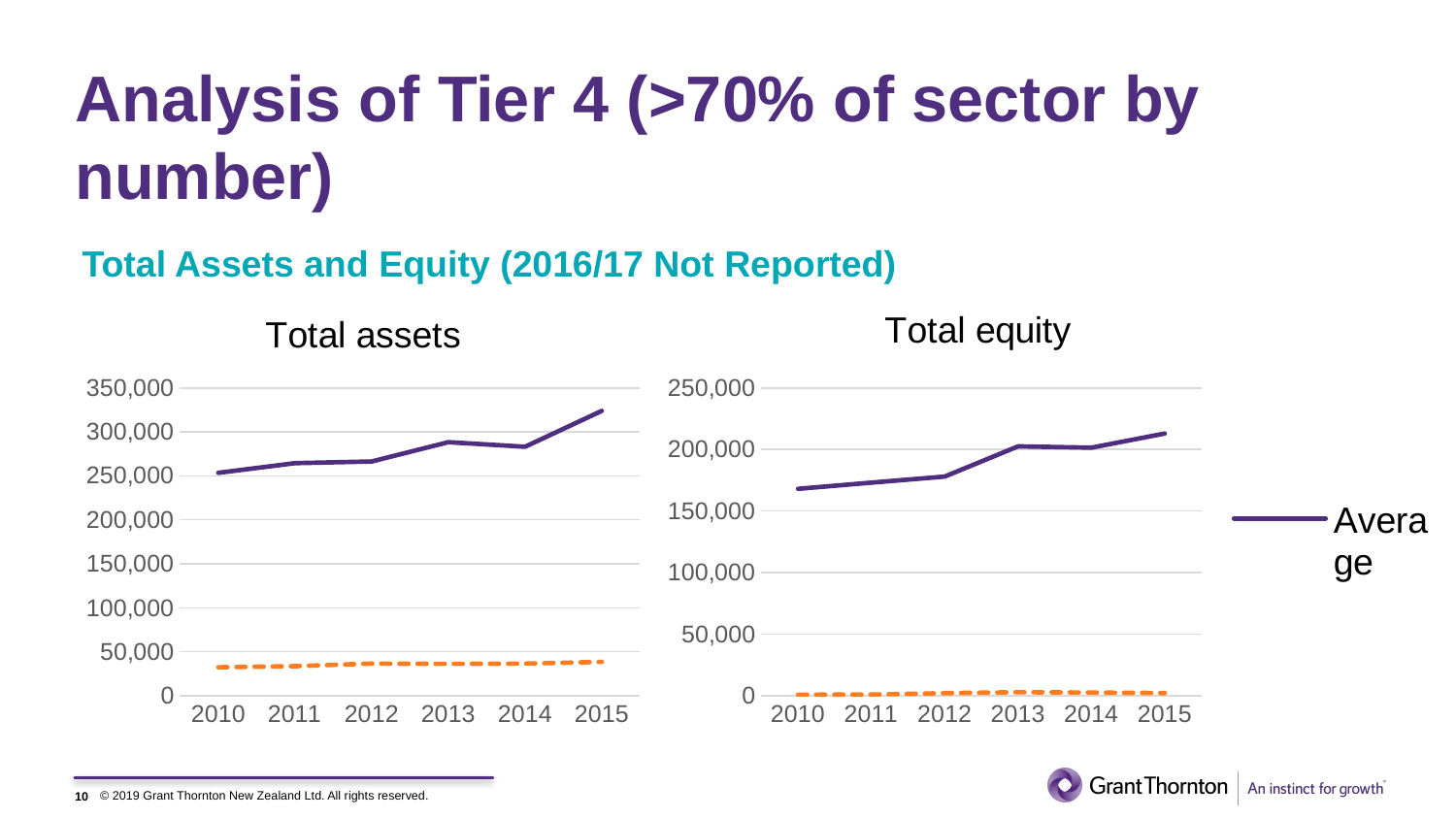
What kind of chart is the Total assets chart? line chart How many years are shown on the x axis of the Total equity chart? 6 In the Total equity chart, is the Average value for 2012 greater or less than 200,000? less In the Total equity chart, does the Average line generally rise or fall from 2010 to 2015? rise How many series does the legend list? 1 In the Total assets chart, is the Average value for 2013 greater or less than 300,000? less In the Total equity chart, which year has the highest value for the Average line? 2015 What is the legend entry shown on the slide? Average In the Total assets chart, is the Average value for 2015 greater or less than 300,000? greater In the Total assets chart, which year has the highest value for the Average line? 2015 In the Total assets chart, which year has the lowest value for the Average line? 2010